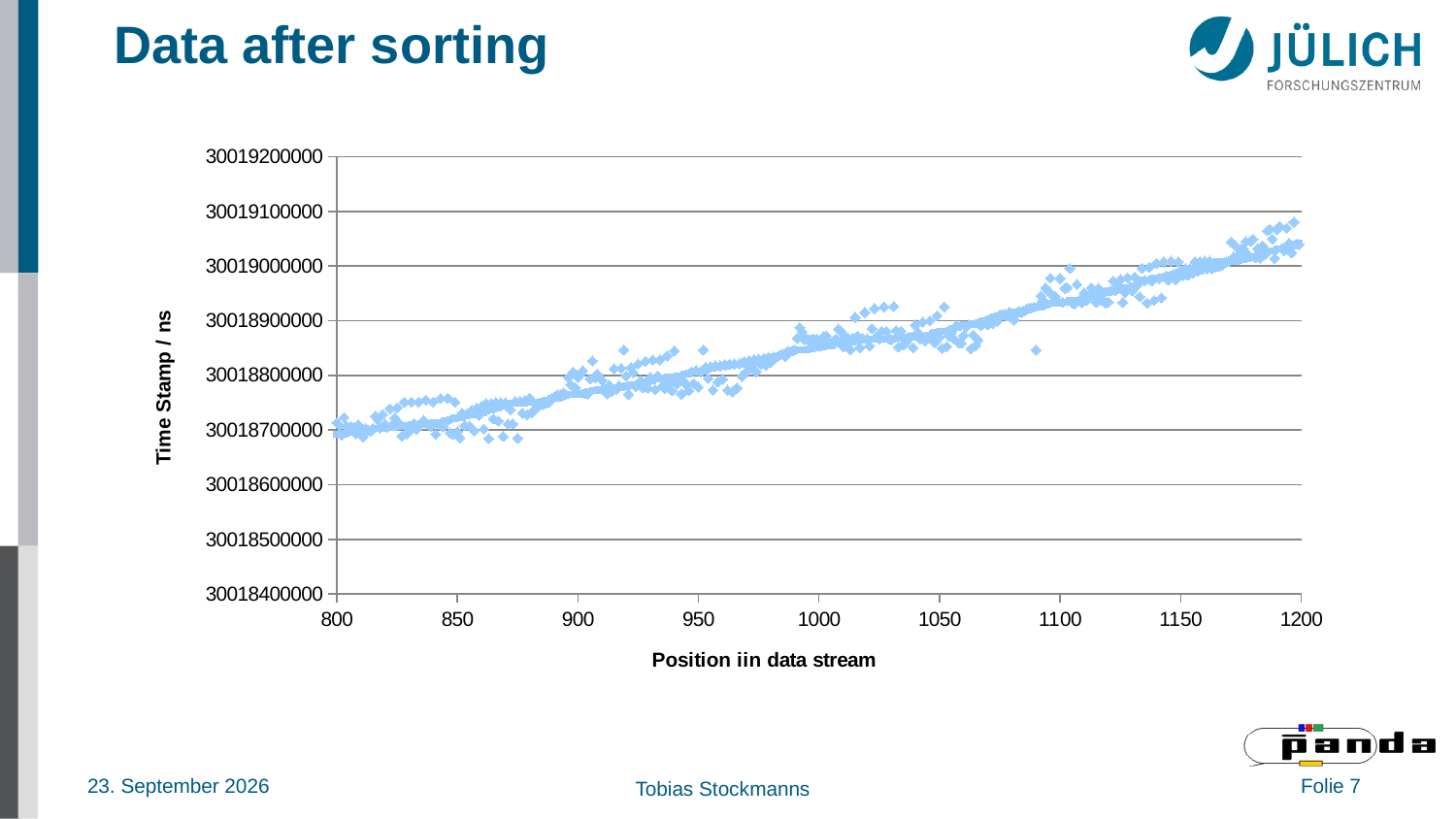
Is the time stamp value at position 800 greater or less than 30018800000? less Are the time stamp values at position 1200 greater or less than those at position 800? greater Is the time stamp value at position 1200 greater or less than 30019000000? greater What is the label of the x axis of the chart? Position iin data stream Do the time stamp values rise or fall as the position in the data stream increases from 800 to 1200? rise Is the time stamp value at position 1100 greater or less than 30018900000? greater What is the label of the y axis of the chart? Time Stamp / ns What kind of chart is shown on the slide? scatter chart